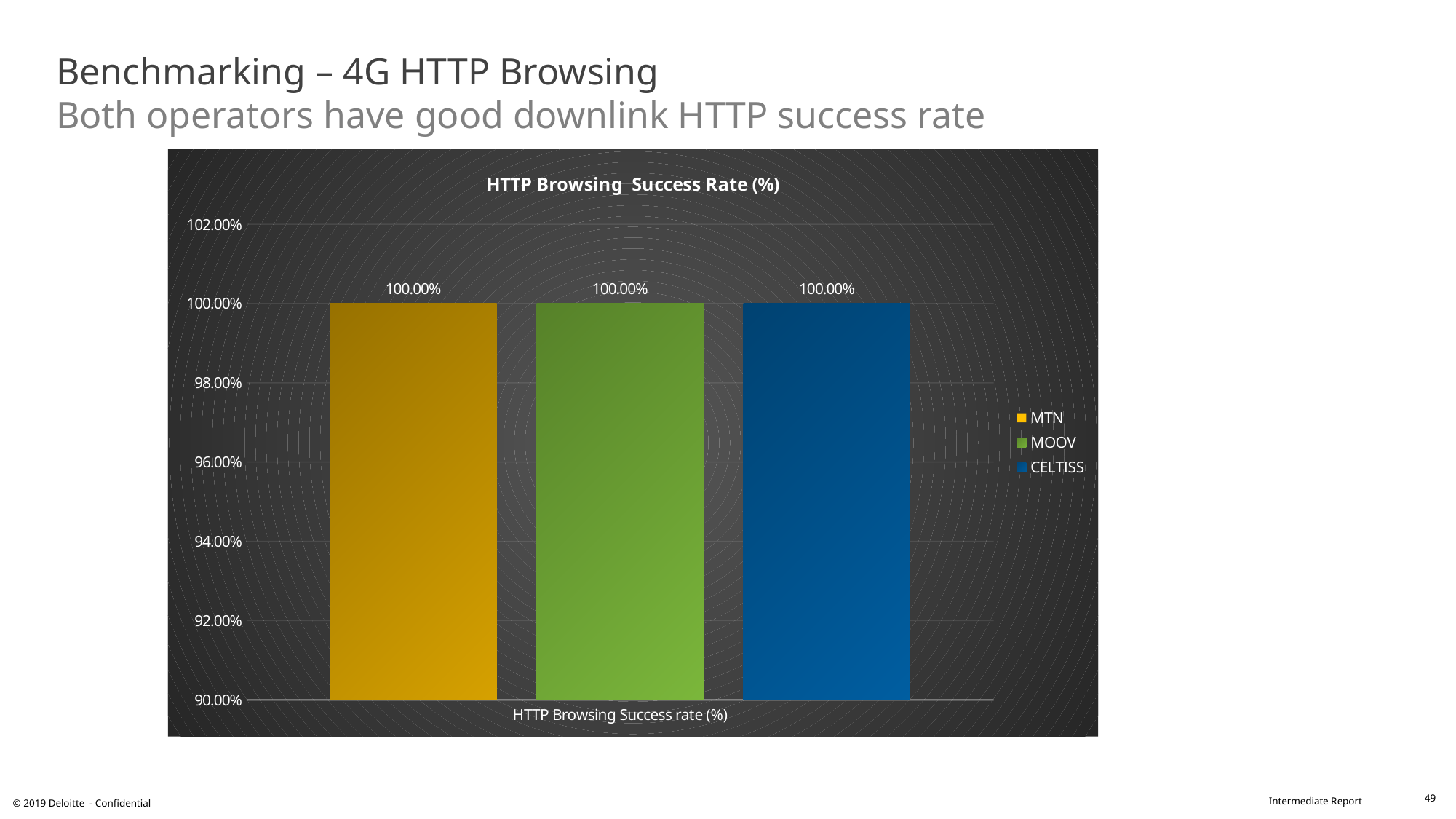
What is the difference between the success rates of MTN and CELTISS? 0.00% How many series does the legend list? 3 How many bars are plotted in the chart? 3 What kind of chart is shown on the slide? bar chart What is the HTTP Browsing Success Rate for CELTISS? 100.00% What is the HTTP Browsing Success Rate for MTN? 100.00% What is the lowest value shown on the vertical axis? 90.00% What is the title of the chart? HTTP Browsing Success Rate (%) What is the HTTP Browsing Success Rate for MOOV? 100.00% Which colour represents CELTISS in the chart? blue Is the value for MOOV greater or less than 98.00%? greater